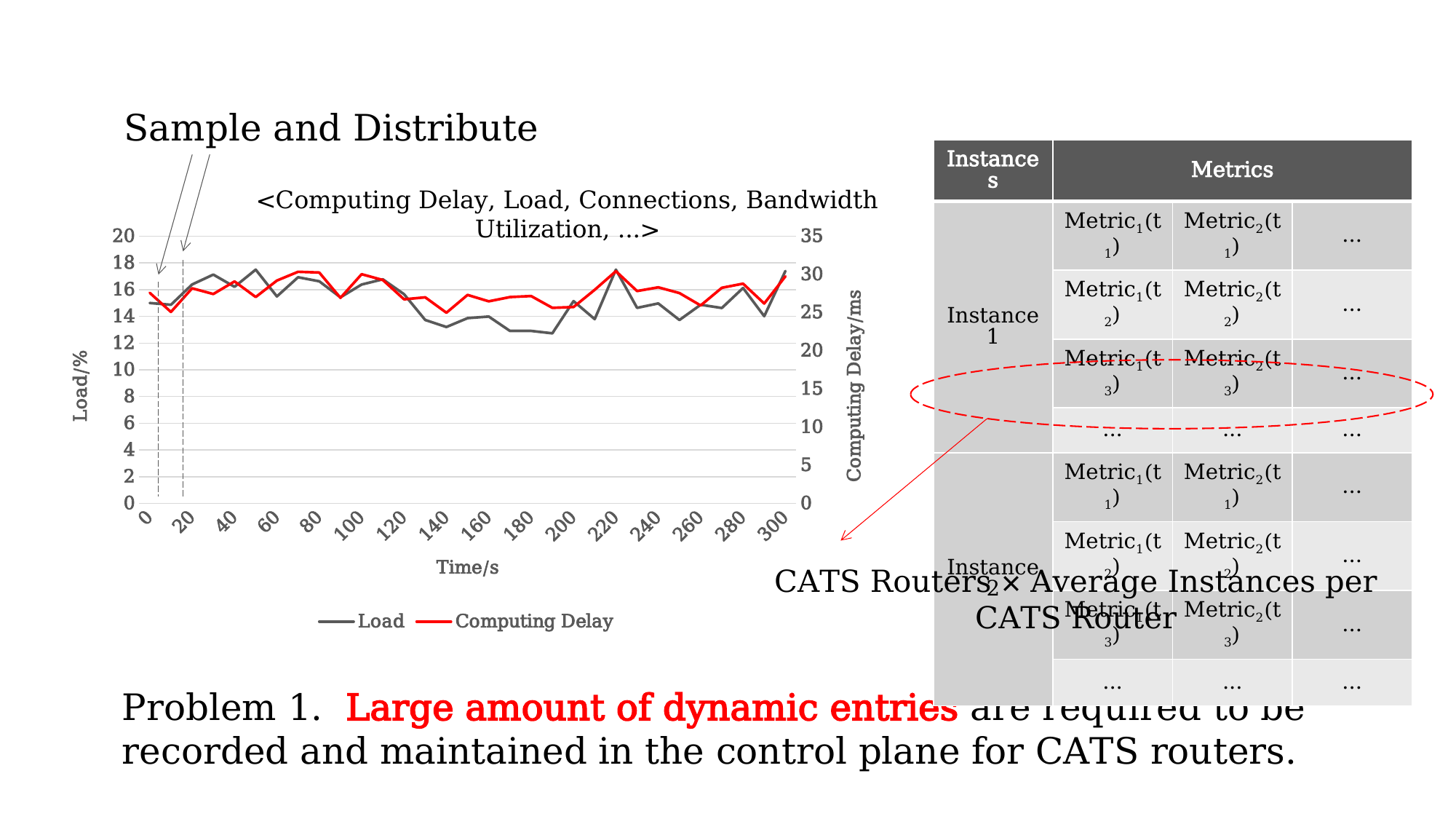
How many tick labels are shown on the chart's x axis? 16 Which is larger, the Load value at time 60 or the Load value at time 180? time 60 What is the title of the chart's x axis? Time/s Is the Computing Delay value at time 0 greater or less than 20? greater What kind of chart is shown on the left of the slide? line chart Does the Load series rise or fall between time 120 and time 180? fall Is the Load value at time 0 greater or less than 10? greater Does the Load series rise or fall between time 200 and time 220? rise How many series does the chart's legend list? 2 Is the Load value at time 180 greater or less than 14? less Which series in the chart is drawn in red? Computing Delay